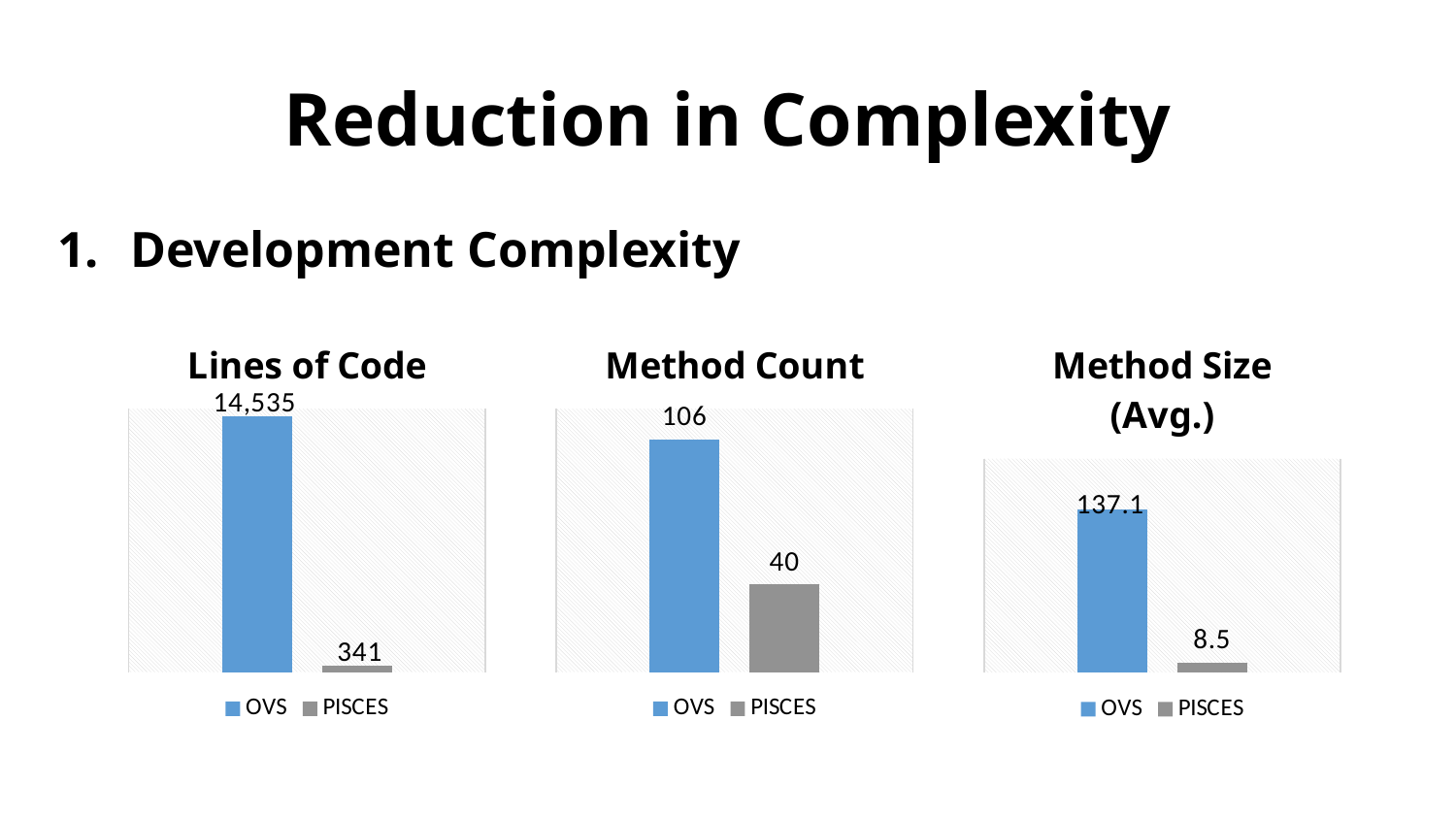
How many charts are shown on the slide? 3 In the Method Size (Avg.) chart, what is the value for OVS? 137.1 In the Method Count chart, what is the difference between the OVS and PISCES values? 66 What kind of chart is the Method Count chart? bar chart In the Method Count chart, what is the value for PISCES? 40 In the Method Count chart, which series has the higher value? OVS In the Lines of Code chart, what is the value for OVS? 14,535 In the Lines of Code chart, which series has the lower value? PISCES In the Method Size (Avg.) chart, what is the value for PISCES? 8.5 In the Method Size (Avg.) chart, is the value for OVS larger or smaller than the value for PISCES? larger How many series does the legend of the Lines of Code chart list? 2 In the Lines of Code chart, what is the value for PISCES? 341